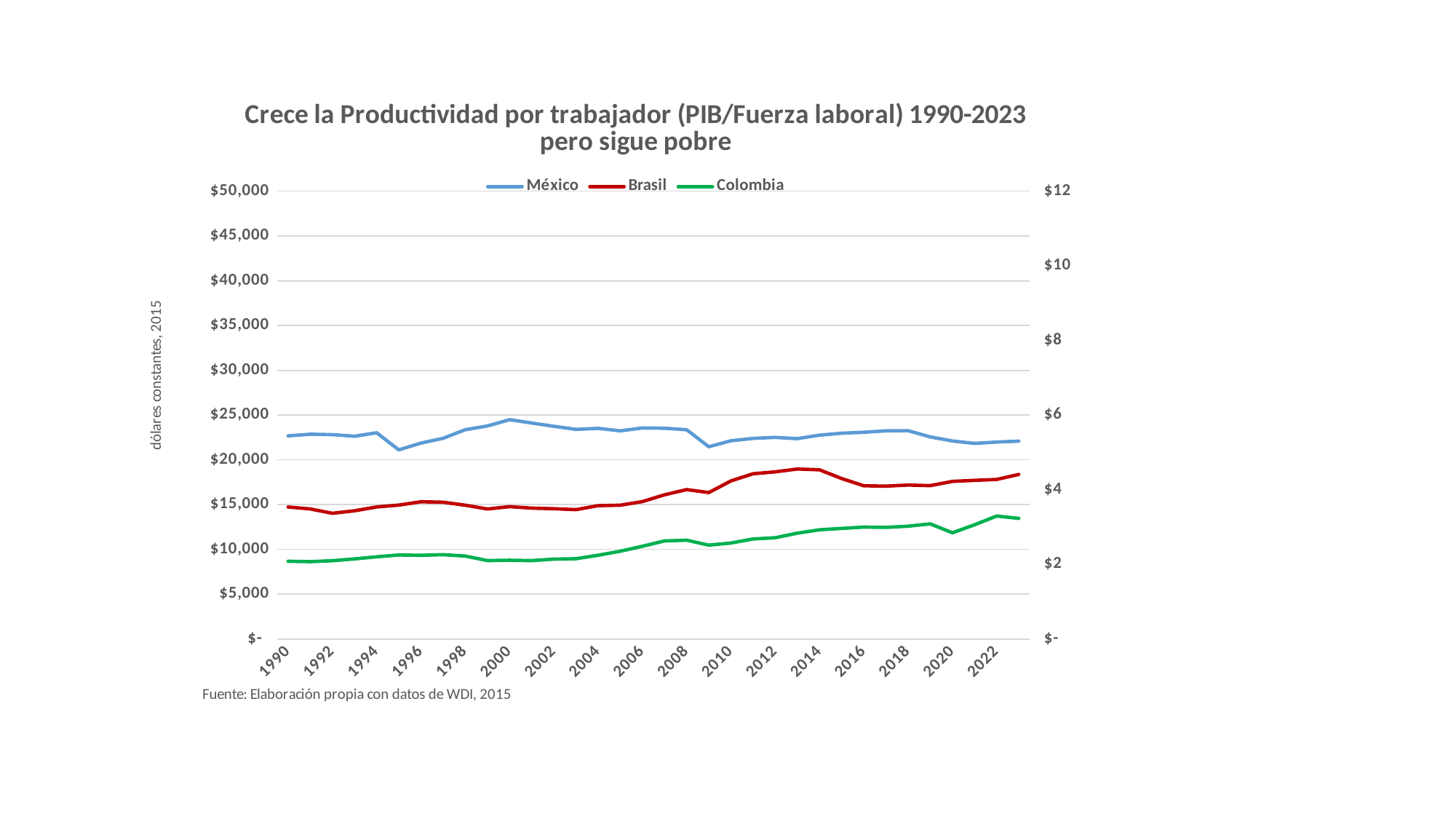
Is the value for Colombia in 1990 greater or less than $10,000? less What is the label on the left vertical axis? dólares constantes, 2015 Which series are listed in the legend? México, Brasil, Colombia Which series has the lowest values across the whole period 1990-2023? Colombia Is the value for México in 1990 greater or less than $20,000? greater How many series does the legend list? 3 Is the value for Brasil in 2014 greater or less than $20,000? less Does the Colombia line overall rise or fall from 1990 to 2023? rise What kind of chart is shown on the slide? line chart Which series has the highest values across the whole period 1990-2023? México In 2010, which is larger, the value for México or the value for Brasil? México